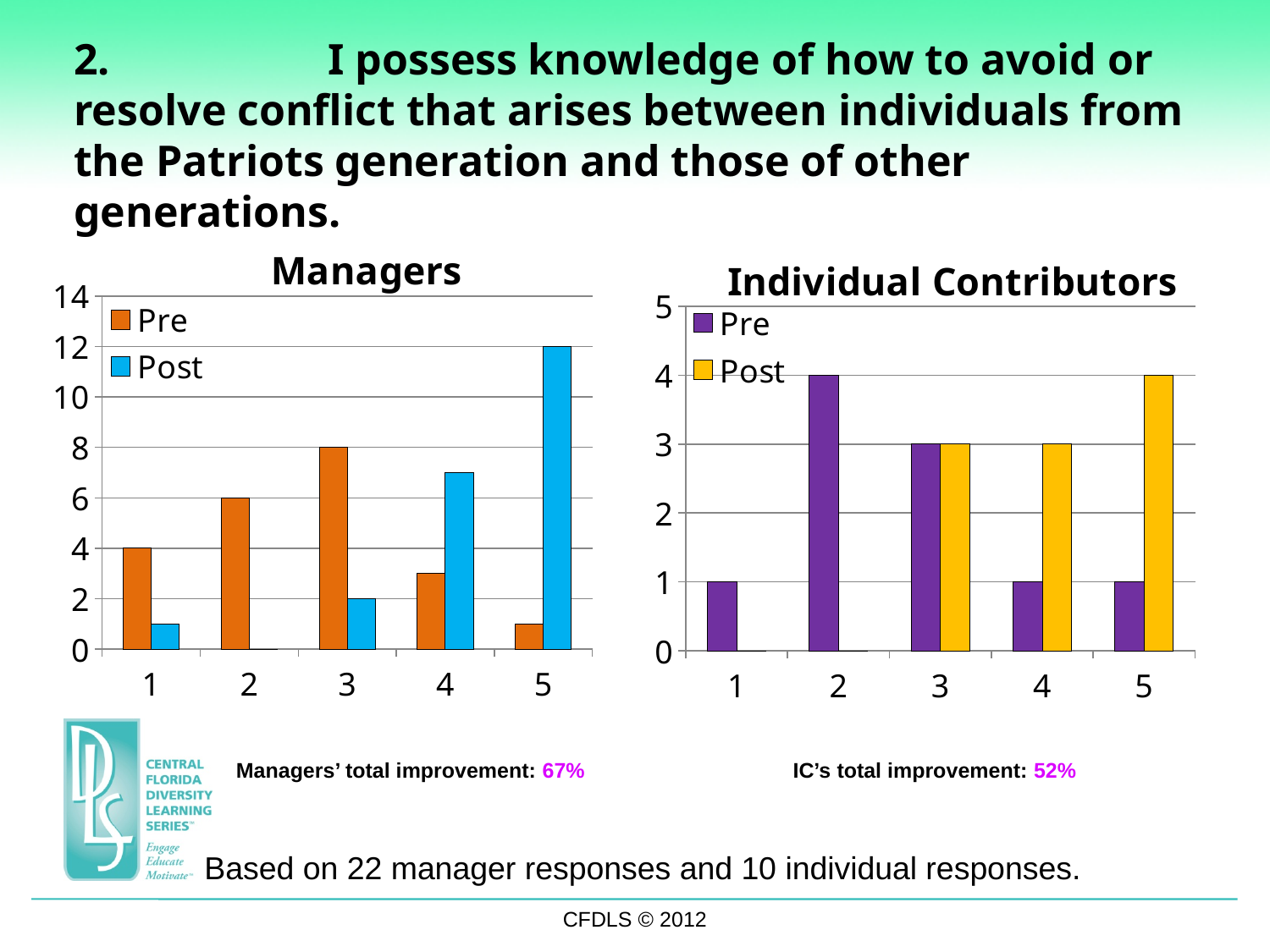
In the Individual Contributors chart, what is the difference between the Post value and the Pre value for category 4? 2 In the Individual Contributors chart, which category has the highest Pre value? 2 In the Managers chart, what is the Pre value for category 3? 8 In the Managers chart, which is larger for category 1, the Pre value or the Post value? Pre In the Individual Contributors chart, what is the Pre value for category 2? 4 In the Managers chart, what is the Post value for category 5? 12 In the Managers chart, which category has the highest Post value? 5 What type of chart is the Managers chart? Bar chart In the Managers chart, is the Post value for category 4 greater or less than 6? greater How many series does the legend of the Individual Contributors chart list? 2 In the Individual Contributors chart, what is the Post value for category 5? 4 In the Managers chart, what is the difference between the Pre value for category 3 and the Pre value for category 2? 2